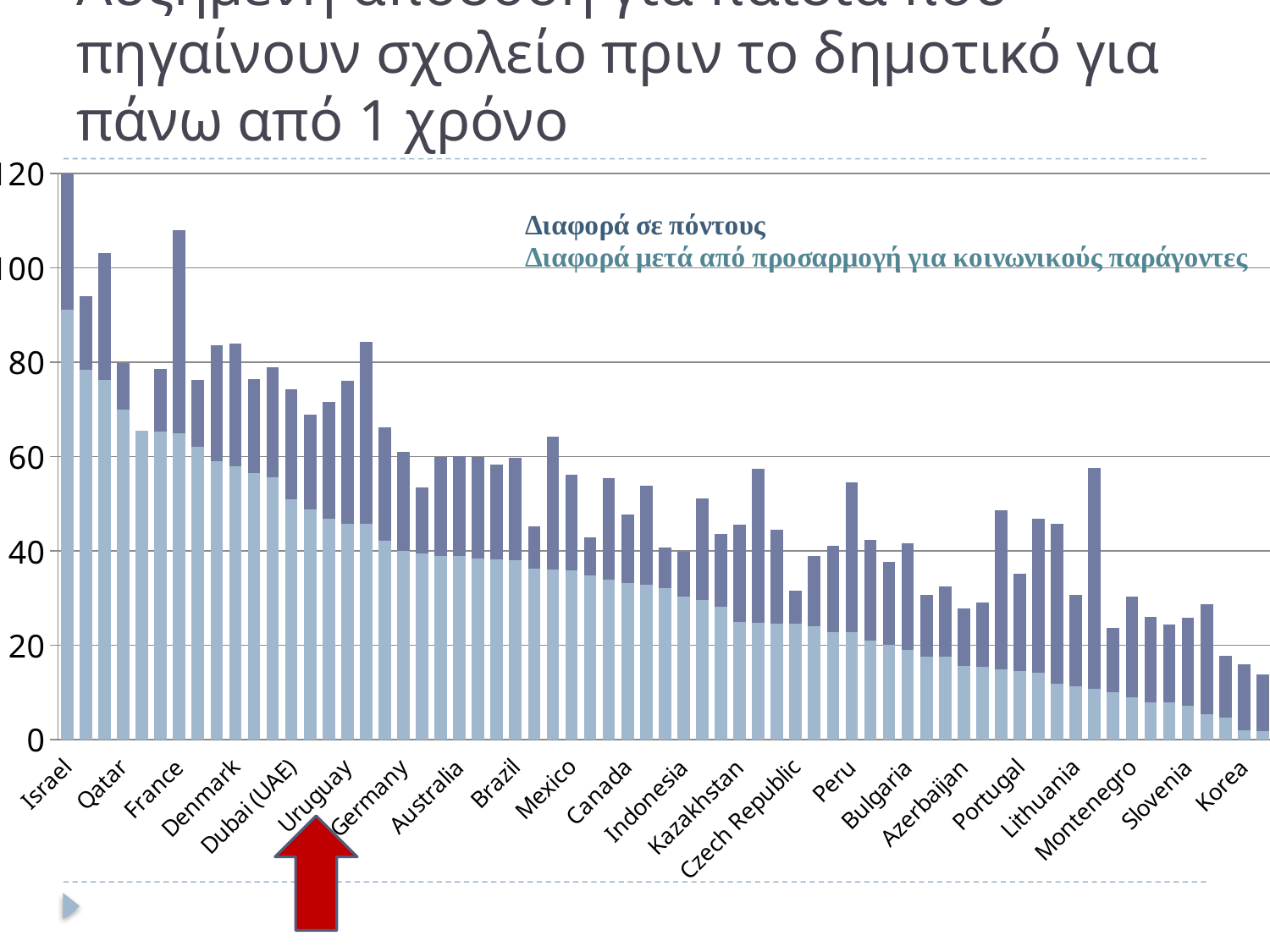
Which has the larger value for Διαφορά σε πόντους, Denmark or Slovenia? Denmark Is the value for Qatar for Διαφορά σε πόντους greater or less than 60? greater Is the value for Korea for Διαφορά σε πόντους greater or less than 20? less What kind of chart is shown on the slide? bar chart How many series does the legend list? 2 How many country labels are shown on the x axis? 22 Which country has the highest value for Διαφορά σε πόντους? Israel Is the value for Israel for Διαφορά σε πόντους greater or less than 100? greater Do the values for Διαφορά σε πόντους generally rise or fall from left to right along the x axis? fall Which has the larger value for Διαφορά σε πόντους, Israel or Korea? Israel Which labelled country has the lowest value for Διαφορά σε πόντους? Korea